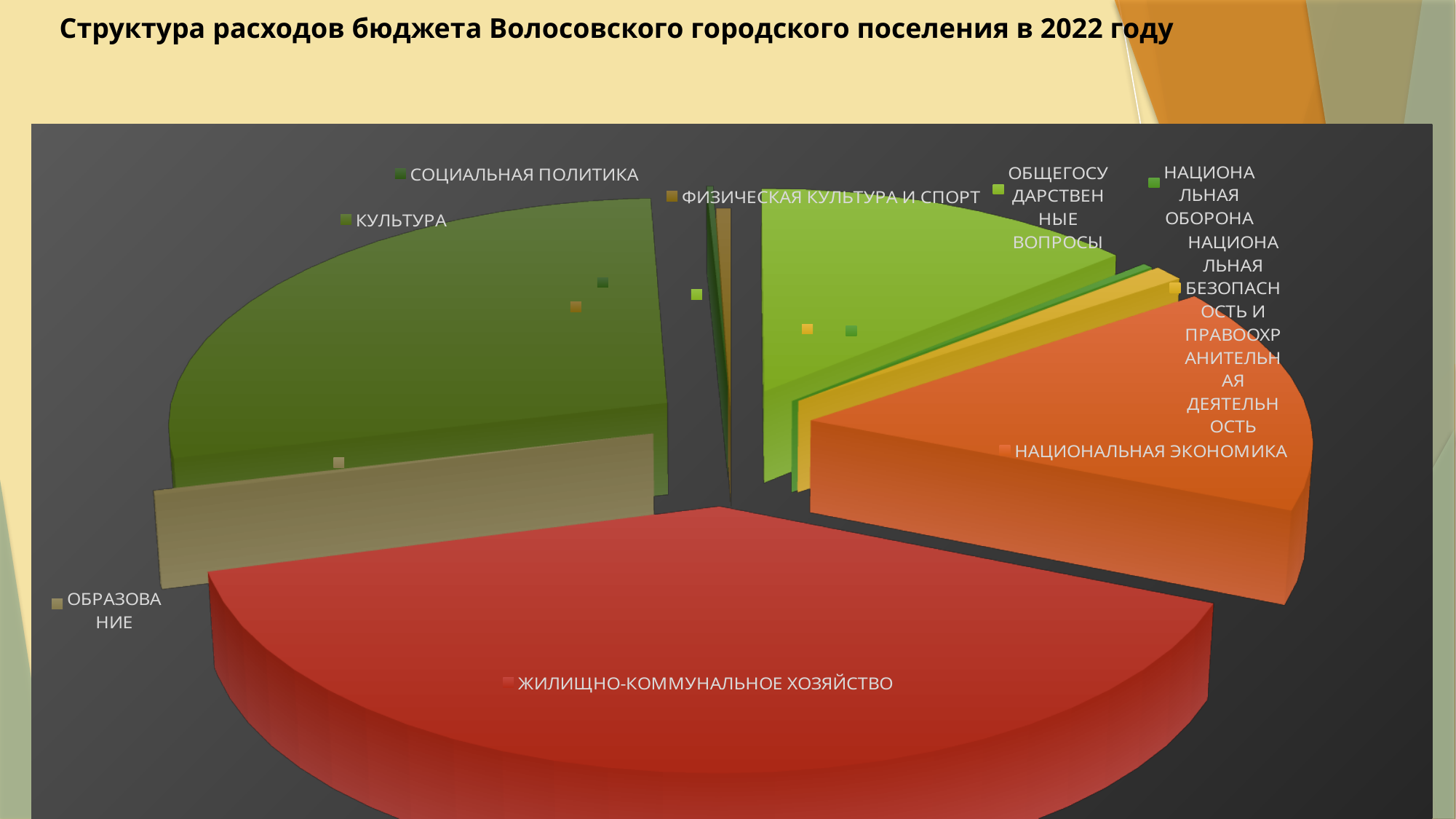
What is the title of the chart on the slide? Структура расходов бюджета Волосовского городского поселения в 2022 году Which category has the largest slice of the pie? Жилищно-коммунальное хозяйство How many categories (slices) are labelled in the pie chart? 9 What colour is the slice for Жилищно-коммунальное хозяйство? red Which slice is larger: Жилищно-коммунальное хозяйство or Образование? Жилищно-коммунальное хозяйство Which slice is larger: Общегосударственные вопросы or Физическая культура и спорт? Общегосударственные вопросы Which slice is larger: Национальная экономика or Образование? Национальная экономика What kind of chart is shown on the slide? pie chart